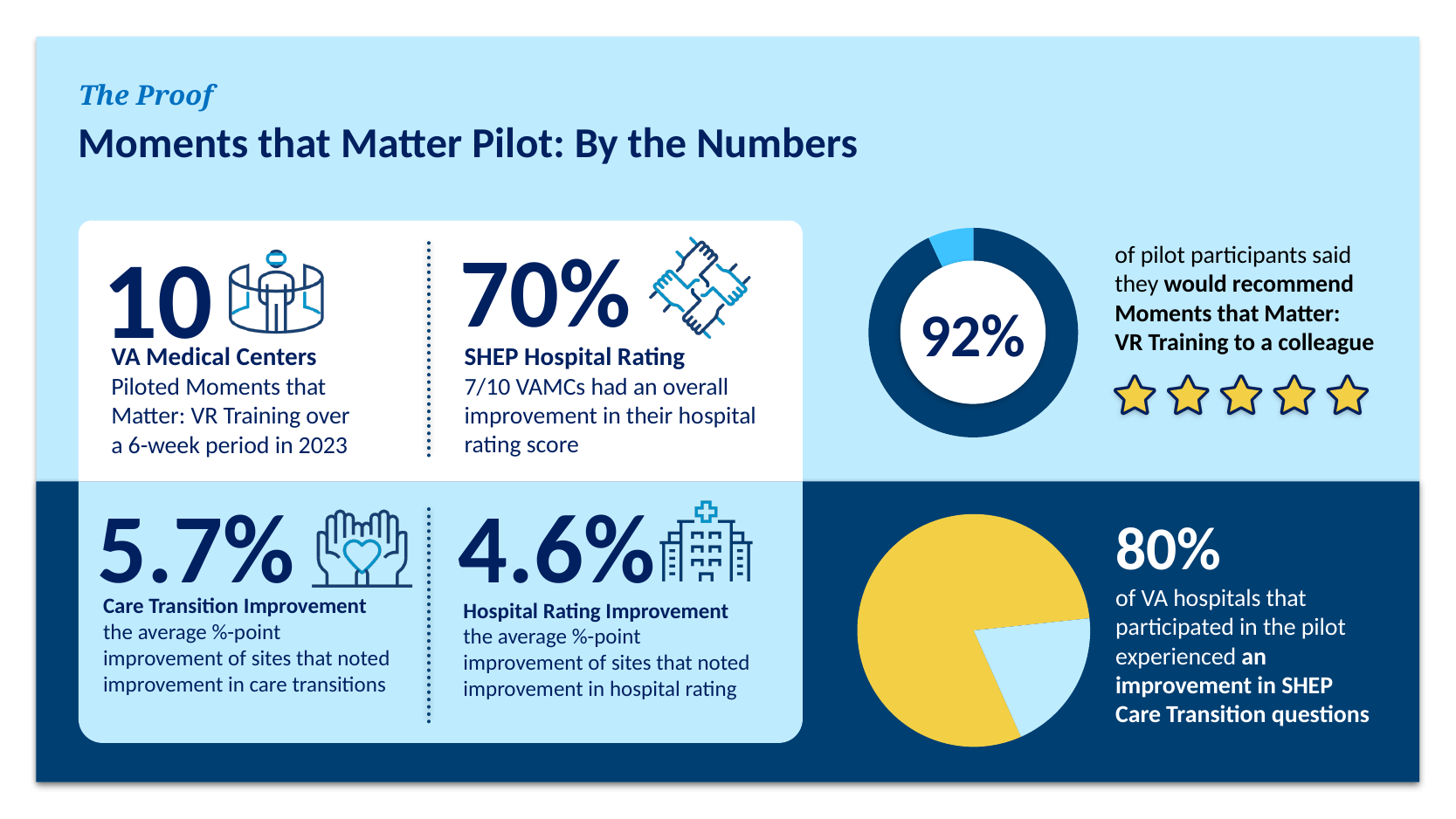
In the bottom-right pie chart, which slice is larger, the yellow one or the light blue one? yellow What does the 80% next to the bottom-right pie chart represent? VA hospitals that participated in the pilot and experienced an improvement in SHEP Care Transition questions In the bottom-right pie chart, what share of the pie does the yellow slice represent? 80% What does the 92% in the top-right donut chart represent? pilot participants who said they would recommend Moments that Matter: VR Training to a colleague What kind of chart is shown in the bottom-right of the slide next to the 80% statistic? pie chart How many segments does the top-right donut chart have? 2 Which chart shows the larger percentage, the top-right donut chart or the bottom-right pie chart? the top-right donut chart What kind of chart is shown in the top-right of the slide next to the text about recommending the training? donut chart How many slices does the bottom-right pie chart have? 2 In the top-right donut chart, which segment is larger, the dark blue one or the light blue one? dark blue In the top-right donut chart, what value is printed in the center? 92% In the bottom-right pie chart, is the yellow slice greater or less than 50% of the pie? greater